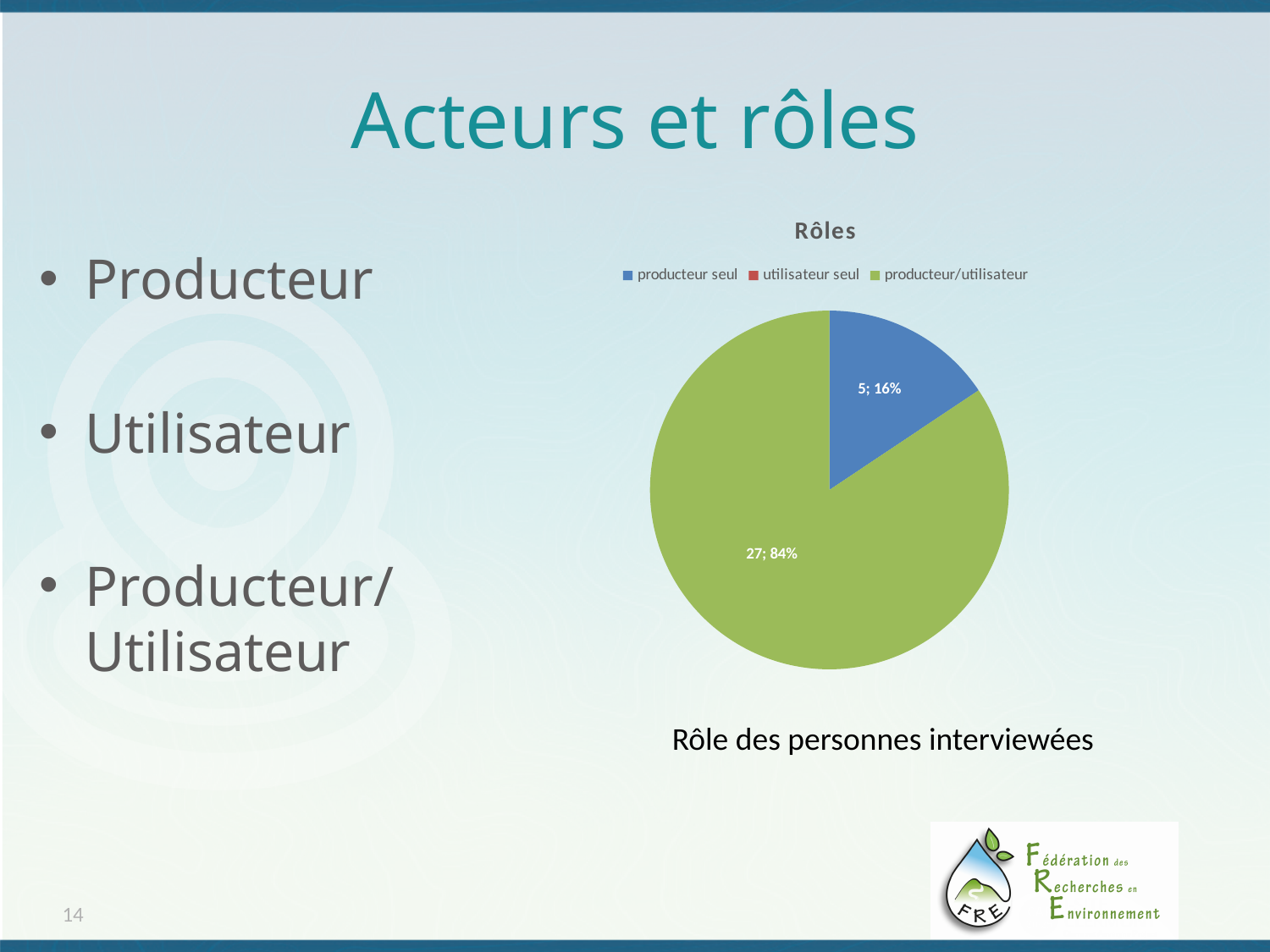
What is the total count of the two labelled slices in the pie? 32 What is the count shown for the 'producteur/utilisateur' slice? 27 What is the difference in count between the 'producteur/utilisateur' slice and the 'producteur seul' slice? 22 What percentage of the pie does the 'producteur/utilisateur' slice represent? 84% What colour is the 'producteur/utilisateur' slice? green Which is larger, the 'producteur seul' slice or the 'producteur/utilisateur' slice? producteur/utilisateur What percentage of the pie does the 'producteur seul' slice represent? 16% Which category has the largest slice of the pie? producteur/utilisateur What is the title of the chart? Rôles How many series does the chart legend list? 3 What kind of chart is shown on the slide? pie chart What is the count shown for the 'producteur seul' slice? 5